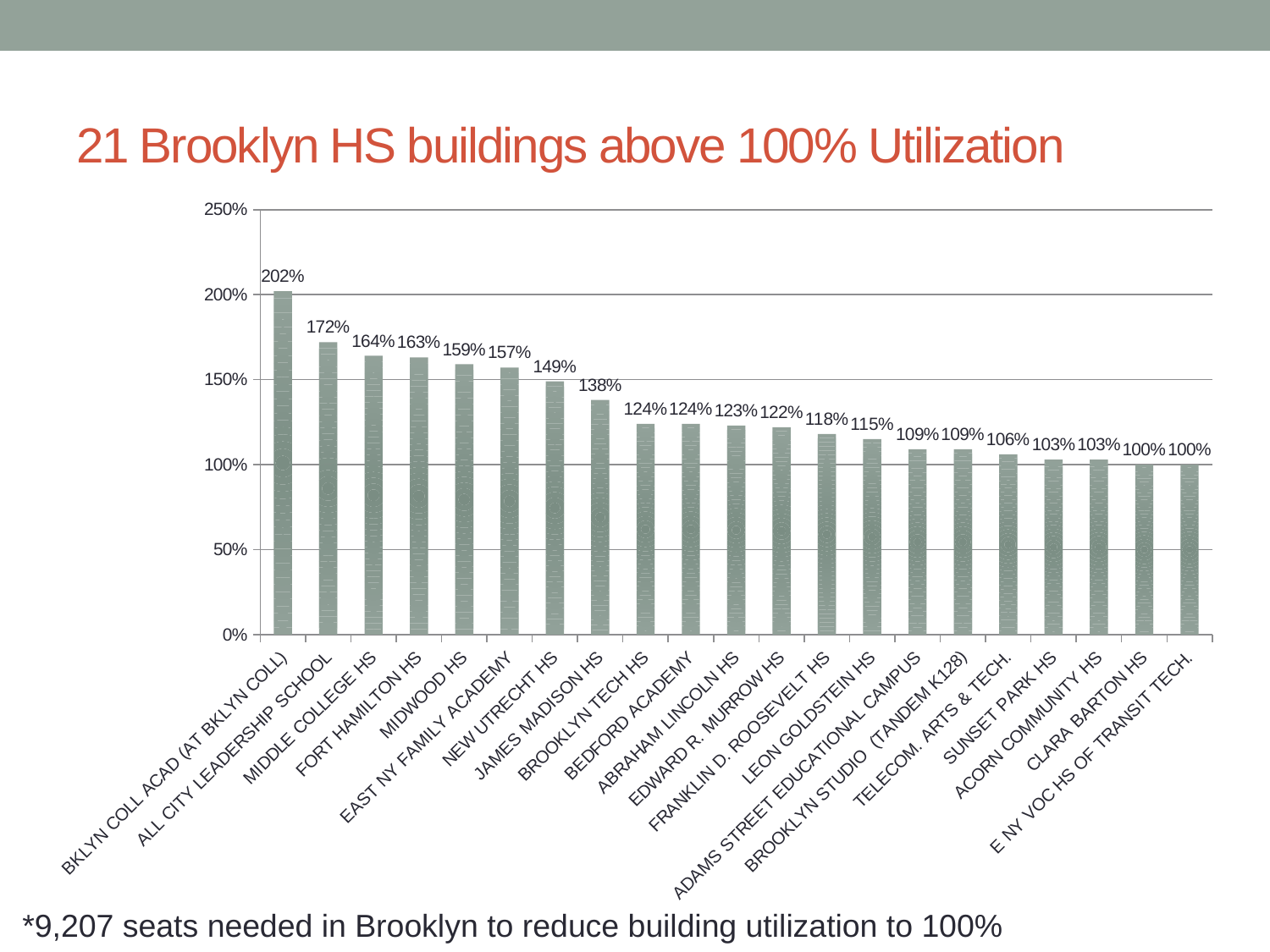
What is the utilization value for LEON GOLDSTEIN HS? 115% What is the lowest utilization value shown on the chart? 100% Which has a higher utilization, FORT HAMILTON HS or EDWARD R. MURROW HS? FORT HAMILTON HS How many buildings are shown on the chart? 21 What is the utilization value for JAMES MADISON HS? 138% What is the difference between the utilization of ALL CITY LEADERSHIP SCHOOL and NEW UTRECHT HS? 23% Is the value for BROOKLYN TECH HS greater or less than 150%? less What is the highest utilization value shown on the chart? 202% Do the values rise or fall from left to right along the x axis? fall What is the utilization value for MIDWOOD HS? 159% What kind of chart is shown on the slide? bar chart Which building has the highest utilization? BKLYN COLL ACAD (AT BKLYN COLL)